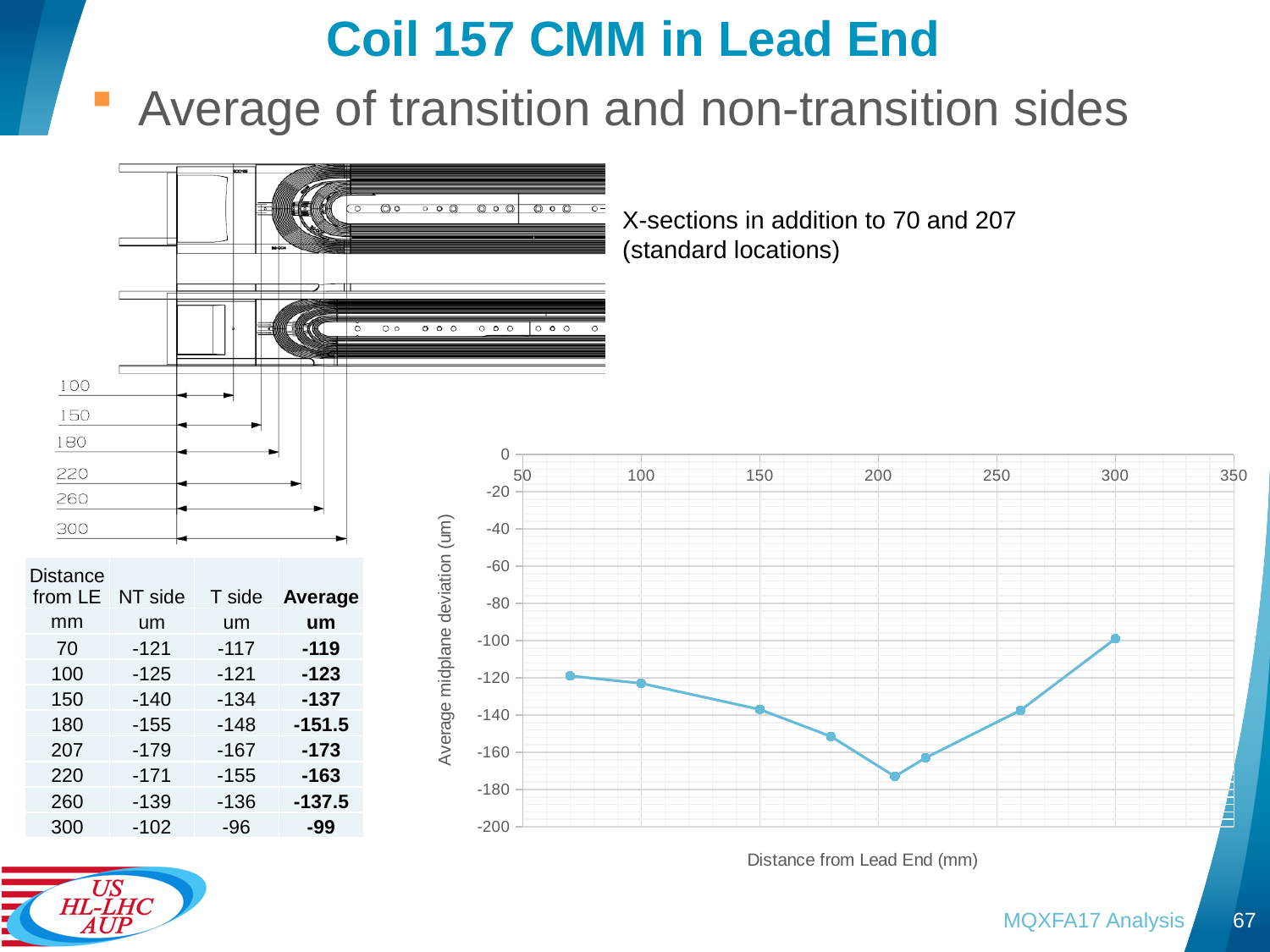
At which distance from the lead end is the average midplane deviation lowest (most negative) on the chart? 207 mm What kind of chart is shown on the slide? line chart What is the title of the x axis of the chart? Distance from Lead End (mm) What is the difference between the average midplane deviation at 300 mm and at 70 mm? 20 um Do the plotted values rise or fall as the distance from the lead end increases from 70 mm to 207 mm? fall What is the average midplane deviation at 207 mm from the lead end? -173 um What is the average midplane deviation at 70 mm from the lead end? -119 um Which has the larger (less negative) average midplane deviation: 100 mm or 260 mm from the lead end? 100 mm At which distance from the lead end is the average midplane deviation highest (least negative) on the chart? 300 mm Is the average midplane deviation at 207 mm greater or less than -160? less How many data points are plotted on the line chart? 8 Is the average midplane deviation at 300 mm greater or less than -100? greater